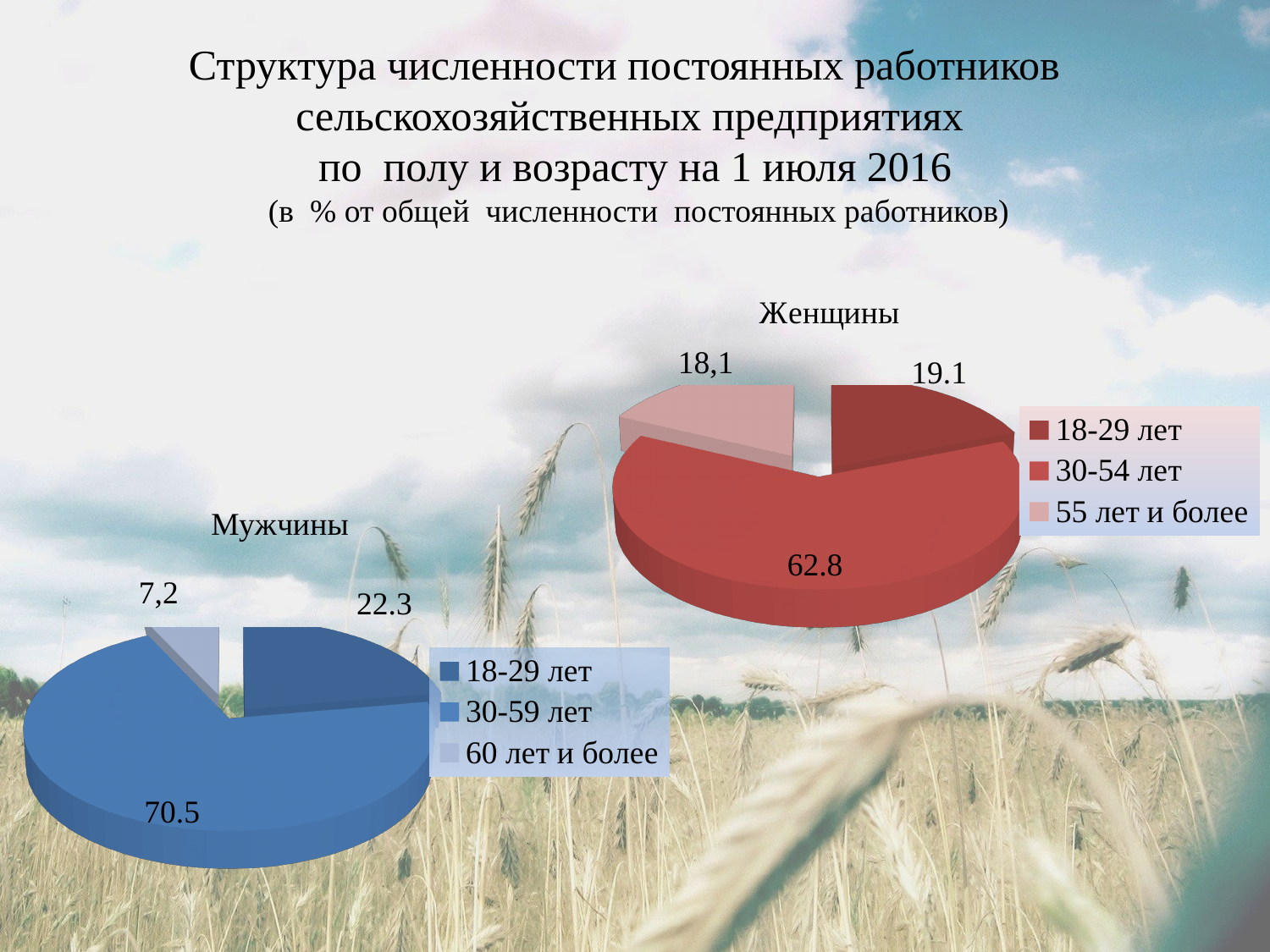
How many slices does the "Женщины" pie chart have? 3 What colour are the slices of the "Женщины" pie chart? Red In the "Женщины" pie chart, what is the value for the 55 лет и более slice? 18,1 In the "Мужчины" pie chart, which age group has the smallest slice? 60 лет и более In the "Мужчины" pie chart, what is the value for the 30-59 лет slice? 70.5 In the "Мужчины" pie chart, what is the value for the 18-29 лет slice? 22.3 In the "Женщины" pie chart, which is larger: the 18-29 лет slice or the 30-54 лет slice? 30-54 лет In the "Женщины" pie chart, which age group has the largest slice? 30-54 лет In the "Мужчины" pie chart, what is the value for the 60 лет и более slice? 7,2 In the "Женщины" pie chart, what is the value for the 30-54 лет slice? 62.8 In the "Мужчины" pie chart, what is the difference between the 30-59 лет slice and the 18-29 лет slice? 48.2 What type of chart is used for "Мужчины"? Pie chart